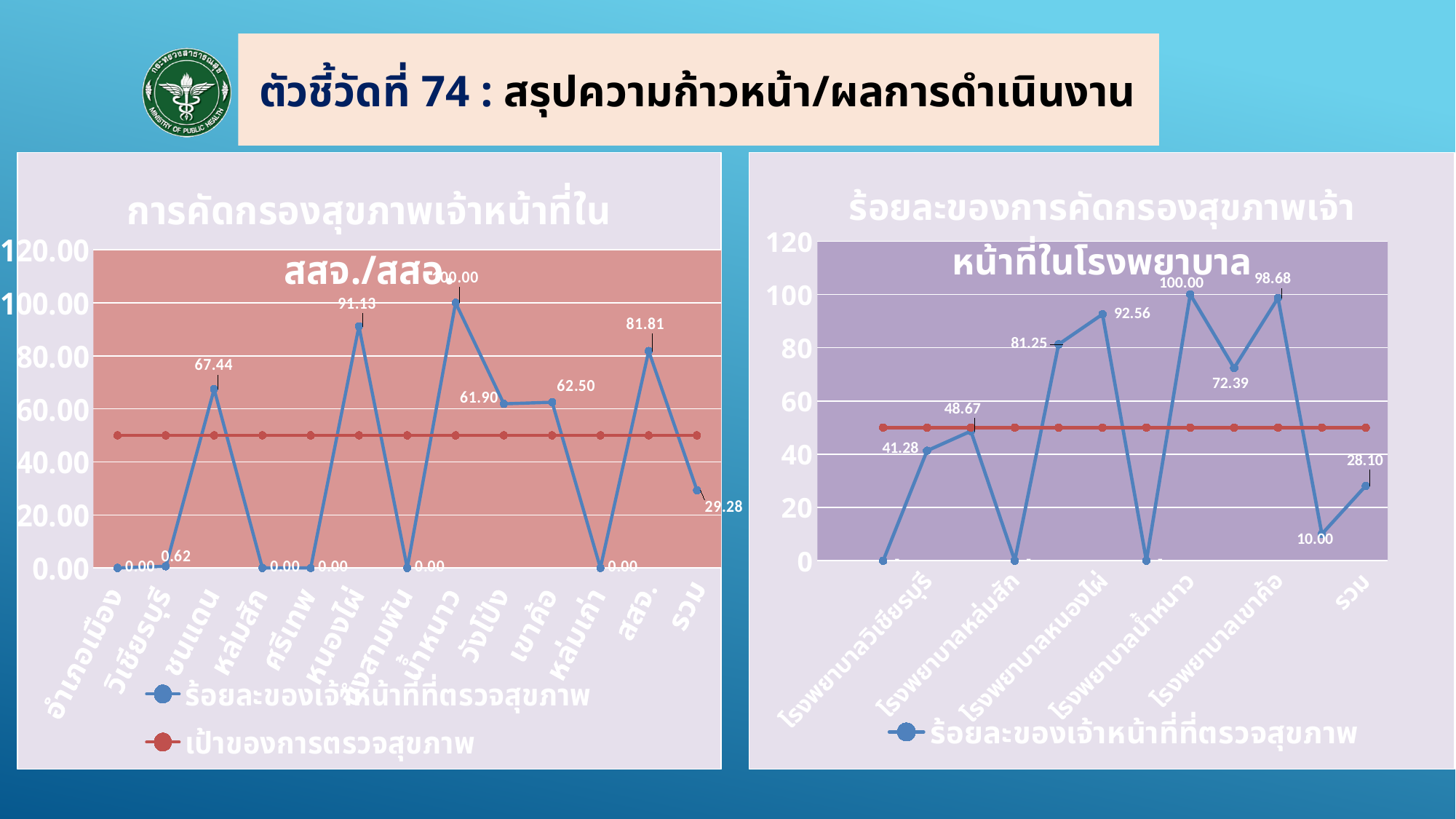
In the left chart (สสจ./สสอ.), what is the value for ชนแดน? 67.44 What kind of chart is the left chart titled การคัดกรองสุขภาพเจ้าหน้าที่ใน สสจ./สสอ.? line chart How many categories are shown on the x axis of the left chart (สสจ./สสอ.)? 13 How many series does the legend of the left chart (สสจ./สสอ.) list? 2 In the left chart (สสจ./สสอ.), what is the value for หนองไผ่? 91.13 In the left chart (สสจ./สสอ.), what is the difference between the values for สสจ. and รวม? 52.53 In the left chart (สสจ./สสอ.), is the red เป้าของการตรวจสุขภาพ line greater or less than 40.00? greater How many series does the legend of the right chart (โรงพยาบาล) list? 1 In the left chart (สสจ./สสอ.), what is the value for รวม? 29.28 In the right chart (โรงพยาบาล), what is the value for รวม? 28.10 In the left chart (สสจ./สสอ.), which category has the highest value for ร้อยละของเจ้าหน้าที่ที่ตรวจสุขภาพ? น้ำหนาว In the left chart (สสจ./สสอ.), which has the larger value, วังโป่ง or เขาค้อ? เขาค้อ